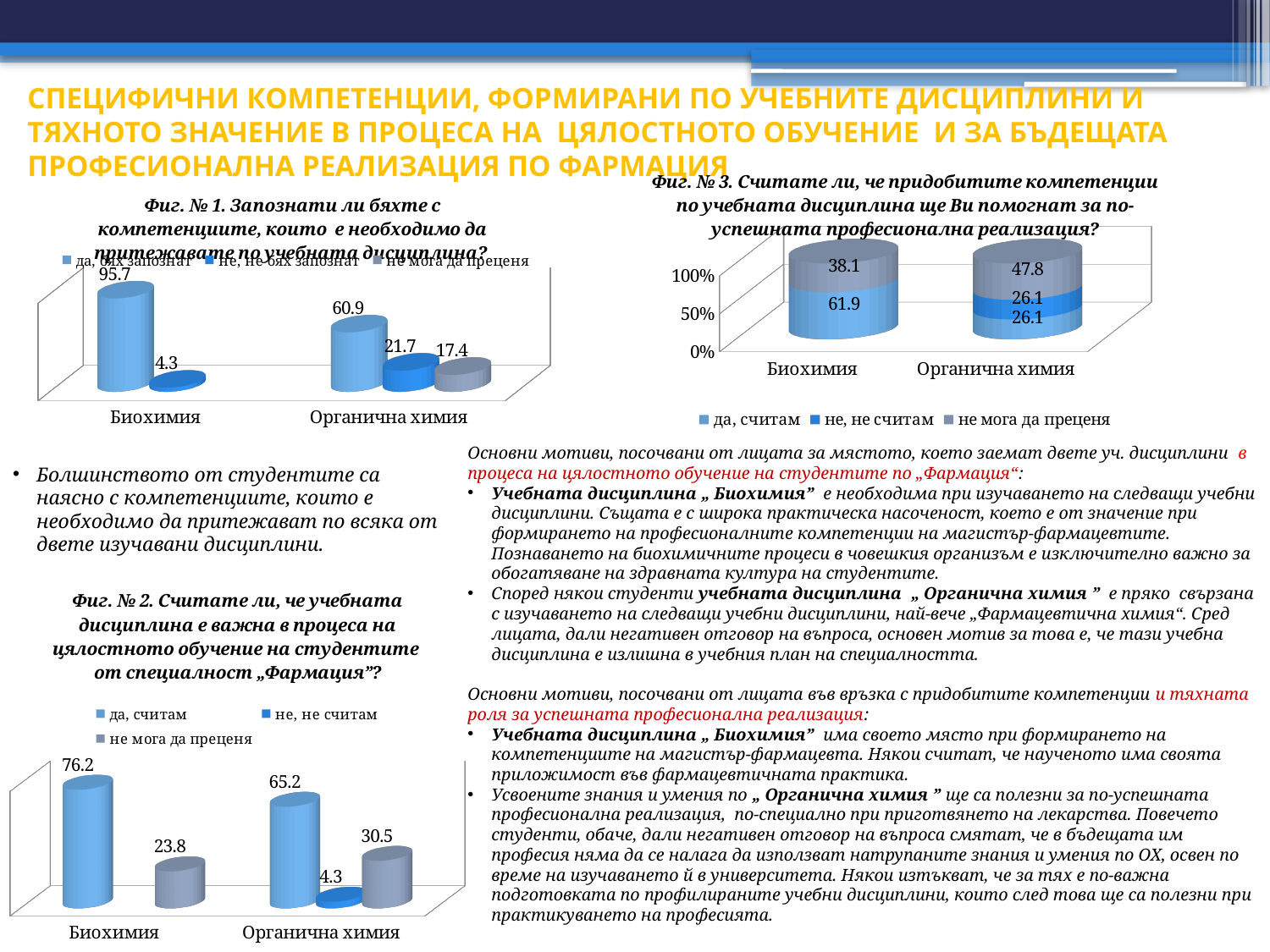
In the chart Фиг. № 1, what is the value for "да, бях запознат" for Биохимия? 95.7 What kind of chart is Фиг. № 3? stacked bar chart In the chart Фиг. № 3, what is the total of the stacked bar for Биохимия? 100 How many categories are shown on the x axis of the chart Фиг. № 2? 2 In the chart Фиг. № 1, what is the value for "не мога да преценя" for Органична химия? 17.4 In the chart Фиг. № 2, what is the value for "да, считам" for Органична химия? 65.2 In the chart Фиг. № 2, what is the value for "не мога да преценя" for Биохимия? 23.8 In the chart Фиг. № 3, what is the value for "да, считам" for Биохимия? 61.9 How many series does the legend of the chart Фиг. № 1 list? 3 In the chart Фиг. № 1, what is the difference between the "да, бях запознат" values for Биохимия and Органична химия? 34.8 In the chart Фиг. № 3, what is the value for "не мога да преценя" for Органична химия? 47.8 In the chart Фиг. № 2, which category has the higher value for "да, считам", Биохимия or Органична химия? Биохимия